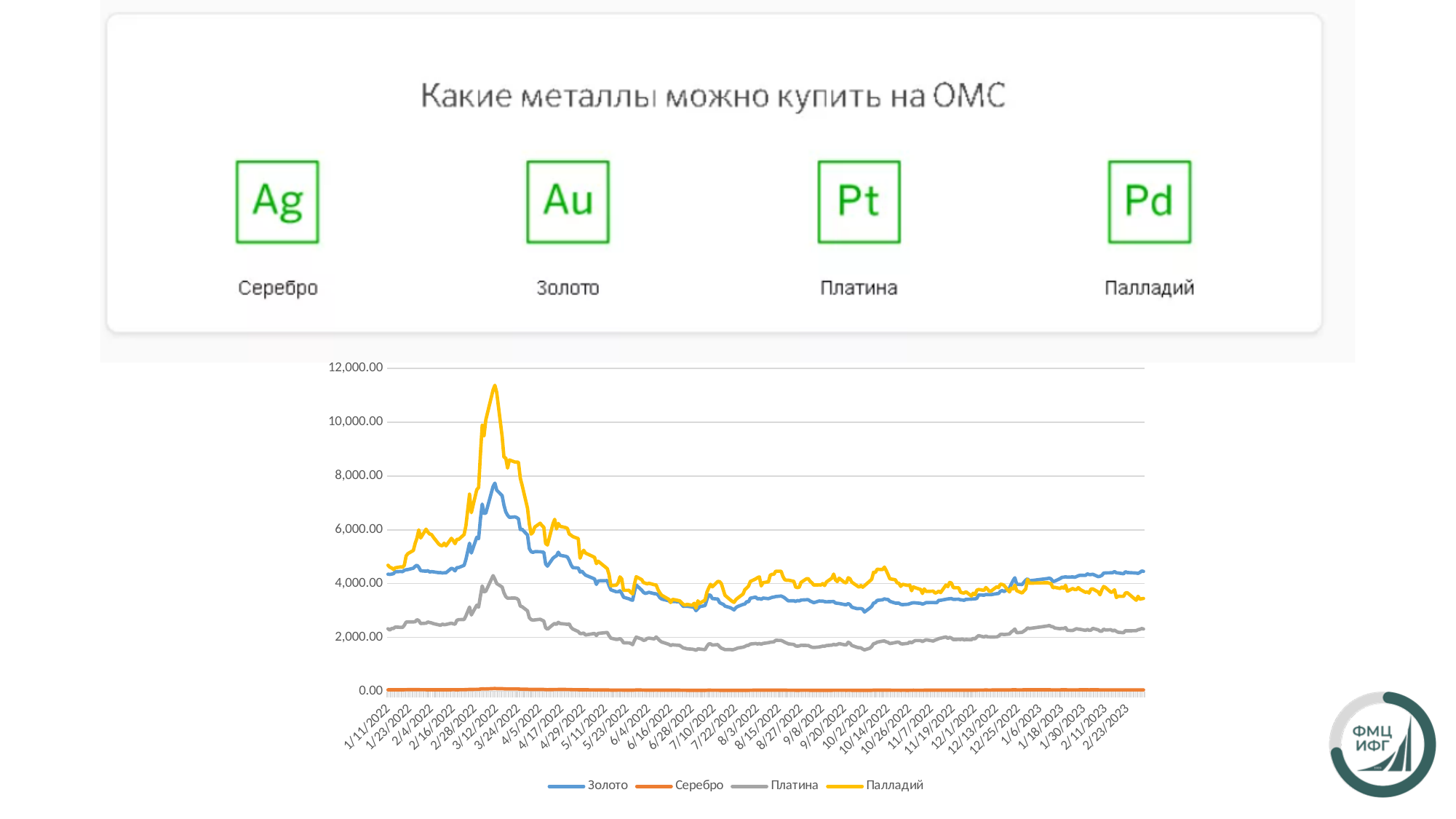
Is the peak value of Золото greater or less than 8,000.00? less On 2/23/2023, which series is higher, Золото or Палладий? Золото What colour is the Золото line in the chart? blue Which series reaches the highest value anywhere on the chart? Палладий Is the value for Платина on 2/23/2023 greater or less than 4,000.00? less Is the peak value of Палладий greater or less than 10,000.00? greater What kind of chart is shown on the slide? line chart Does the Палладий line rise or fall between 3/12/2022 and 6/16/2022? fall How many series does the chart legend list? 4 Around 3/12/2022, which series is higher, Палладий or Платина? Палладий Which series stays lowest across the whole chart? Серебро